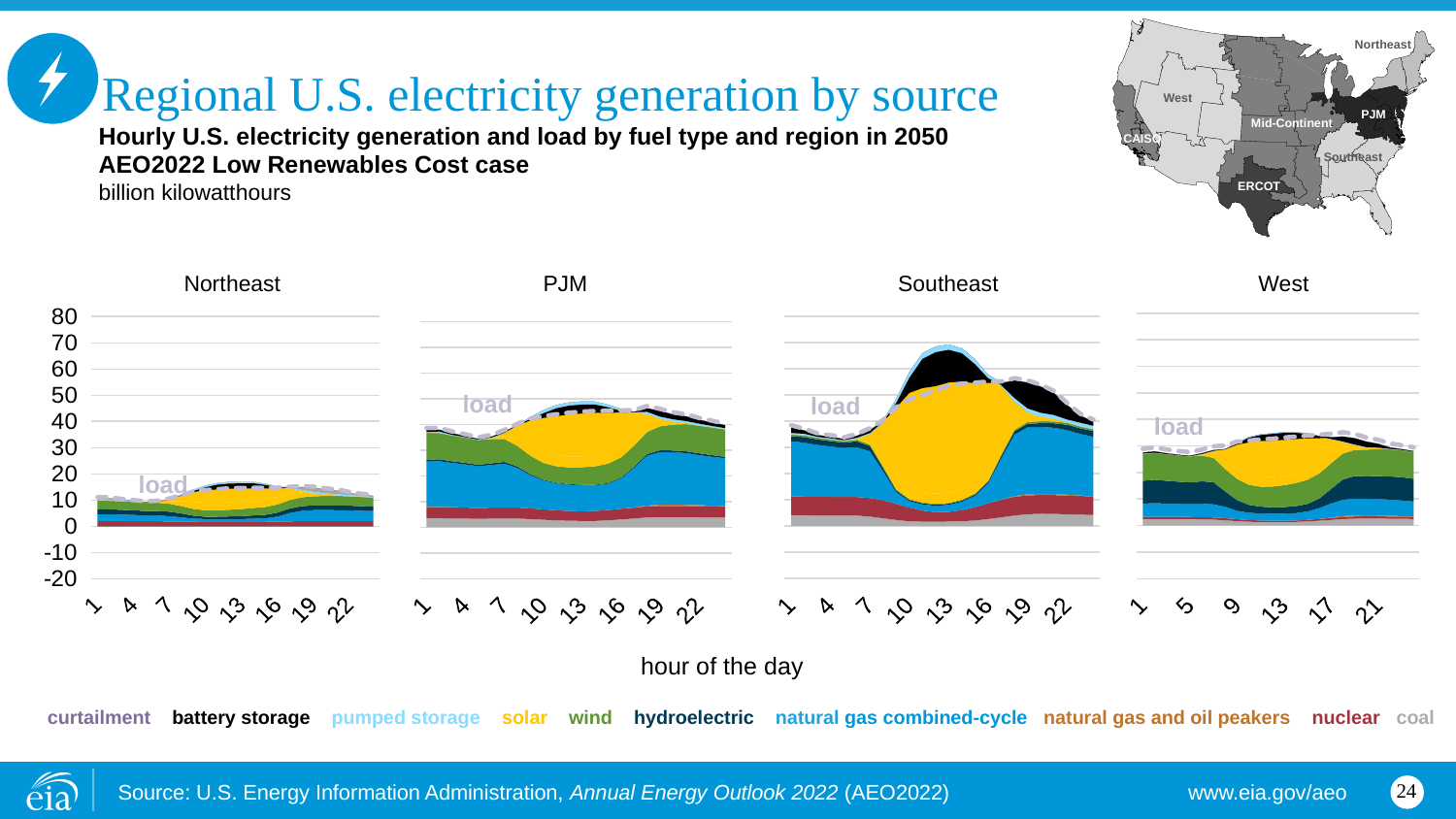
In the Northeast chart, is the peak load value greater or less than 20? less How many fuel-type series does the legend at the bottom of the slide list? 10 Which region's chart shows the lowest peak load among the four regions? Northeast In the Southeast chart, does generation rise or fall from hour 7 to hour 13? rise What unit is used for the y axis of the charts? billion kilowatthours In the West chart, is the peak load greater or less than 50? less Which region's chart shows the highest peak generation: Northeast or Southeast? Southeast In the Southeast chart, is the peak total generation greater or less than 50? greater What kind of chart is used for each of the four regional panels on the slide? stacked area chart How many regional charts are shown on the slide? 4 What is the x-axis label shared by the four charts? hour of the day